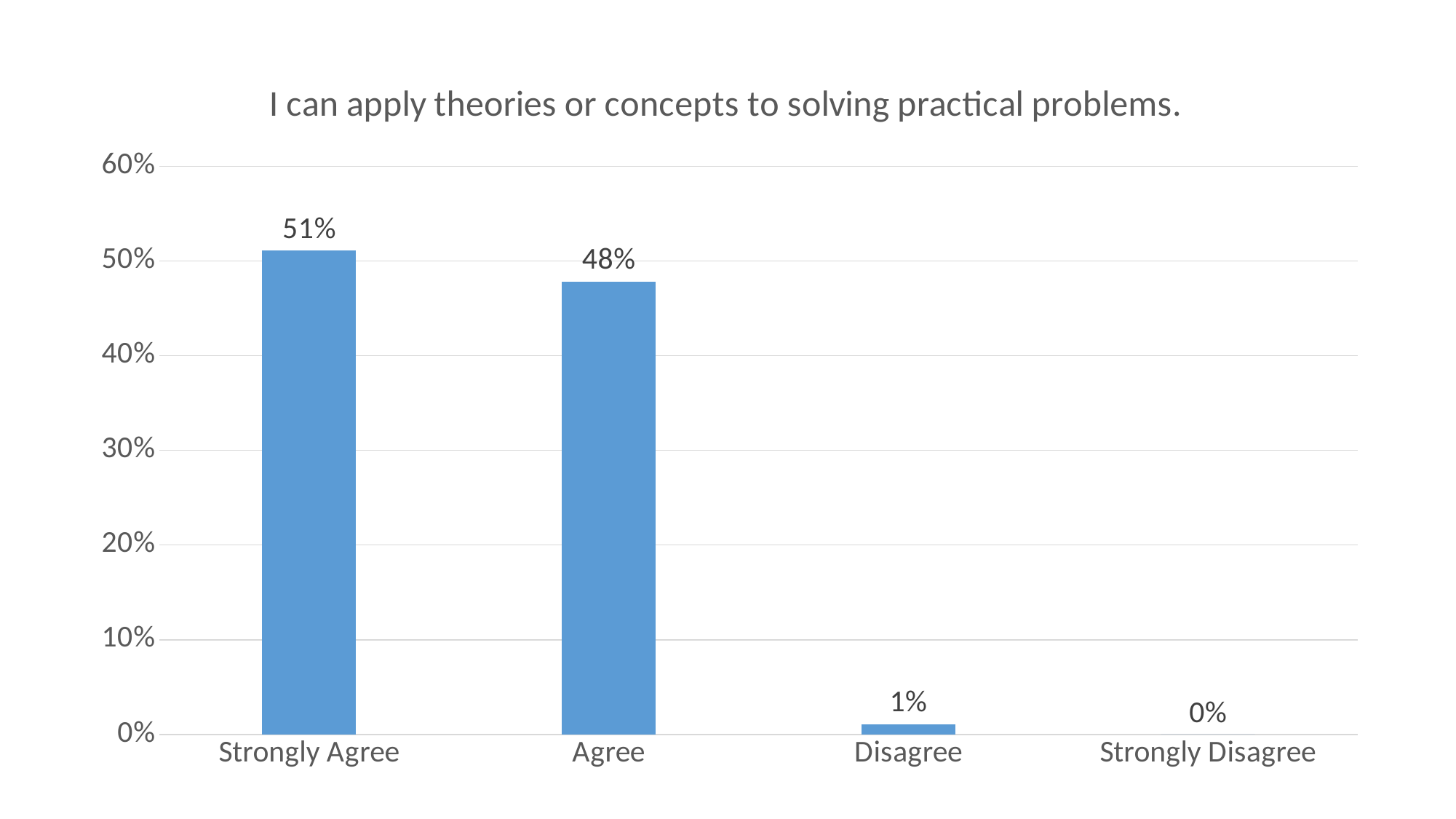
What is the title of the chart? I can apply theories or concepts to solving practical problems. What is the value for Disagree? 1% Which is larger, the value for Agree or the value for Disagree? Agree What is the value for Strongly Disagree? 0% Which category has the highest value? Strongly Agree What kind of chart is shown on the slide? bar chart How many categories are shown on the x axis? 4 Which category has the lowest value? Strongly Disagree What is the value for Strongly Agree? 51% What is the difference between the values for Strongly Agree and Agree? 3% What is the value for Agree? 48% Is the value for Agree greater or less than 40%? greater